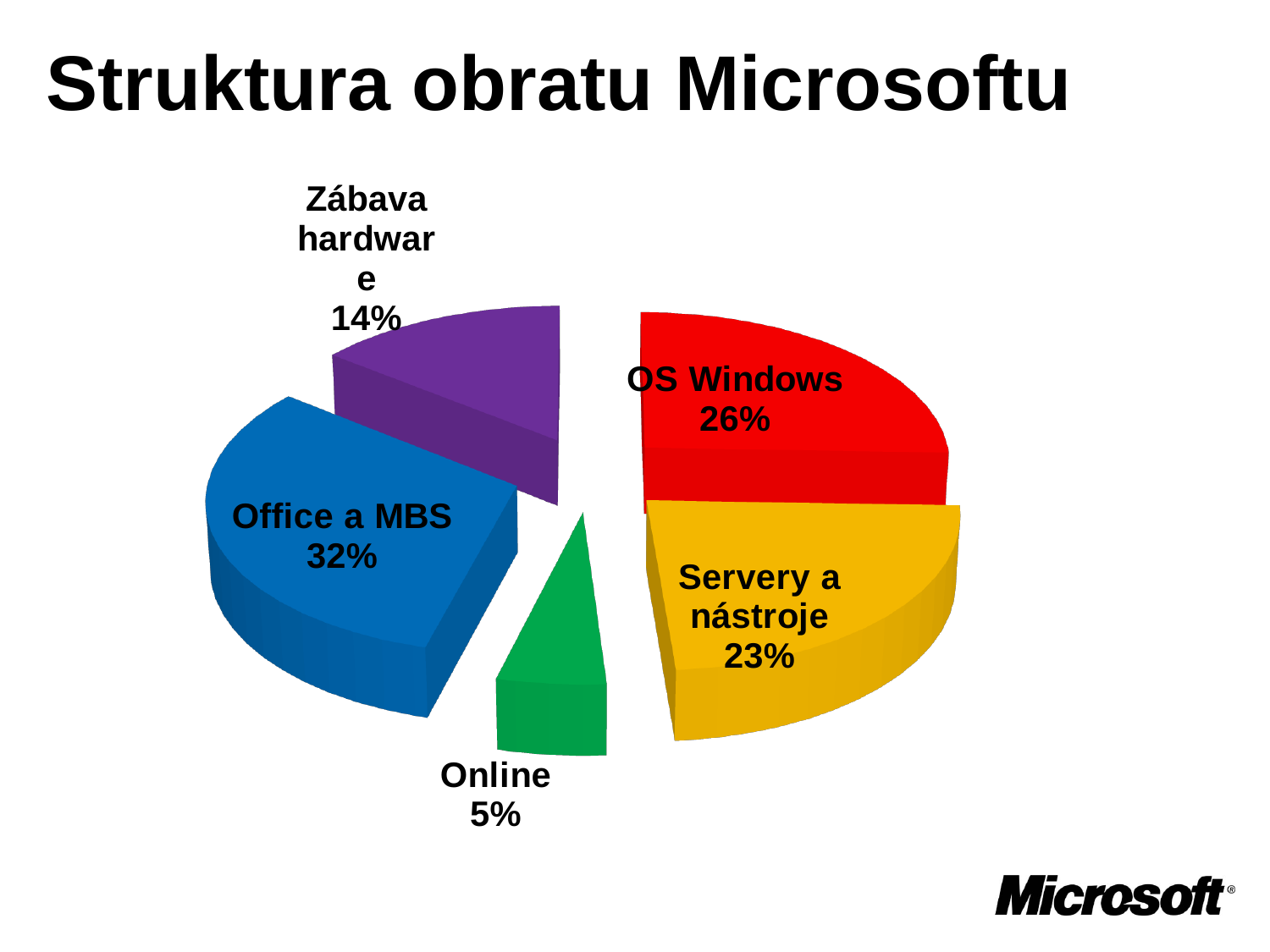
What percentage is shown for Servery a nástroje? 23% What is the difference in percentage points between Office a MBS and OS Windows? 6 Which segment has the largest share of the pie? Office a MBS What percentage is shown for Online? 5% What percentage is shown for Zábava hardware? 14% What share of Microsoft's revenue does Office a MBS account for? 32% What percentage is shown for OS Windows? 26% Which segment has the smallest share of the pie? Online What is the title of the chart on the slide? Struktura obratu Microsoftu Which is larger, the share for OS Windows or the share for Servery a nástroje? OS Windows How many segments does the pie chart have? 5 What kind of chart is shown on the slide? Pie chart